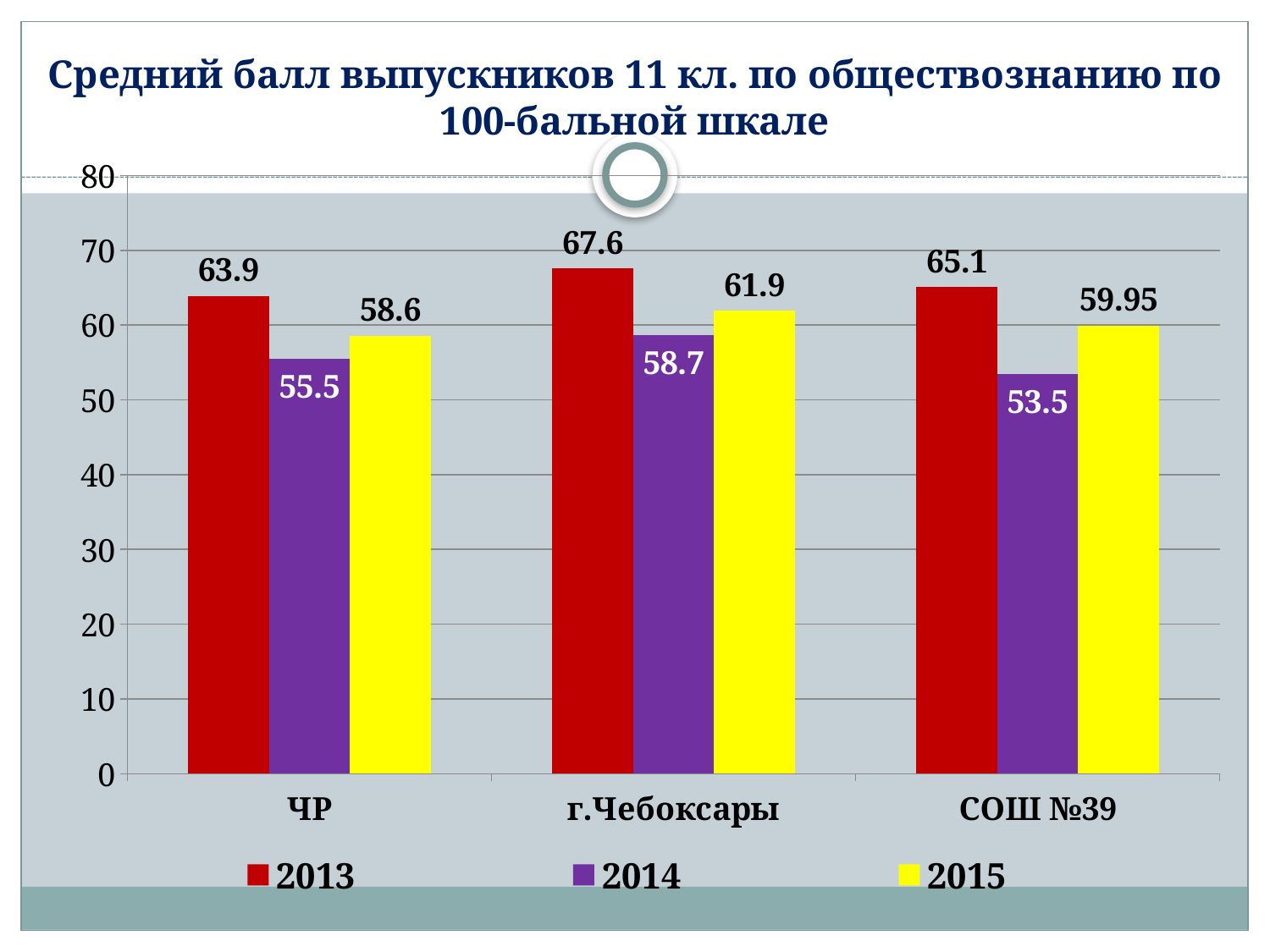
Which category has the highest value for 2013? г.Чебоксары What is the value for 2013 in the ЧР category? 63.9 Which colour represents the 2015 series in the legend? yellow Is the value for 2014 in г.Чебоксары greater or less than 60? less What kind of chart is shown on the slide? bar chart What is the difference between the 2013 and 2014 values for ЧР? 8.4 What is the value for 2014 in the СОШ №39 category? 53.5 What is the value for 2015 in the г.Чебоксары category? 61.9 How many series does the legend list? 3 Which category has the lowest value for 2014? СОШ №39 Which is larger: the 2015 value for СОШ №39 or the 2015 value for ЧР? СОШ №39 How many categories are shown on the x axis? 3